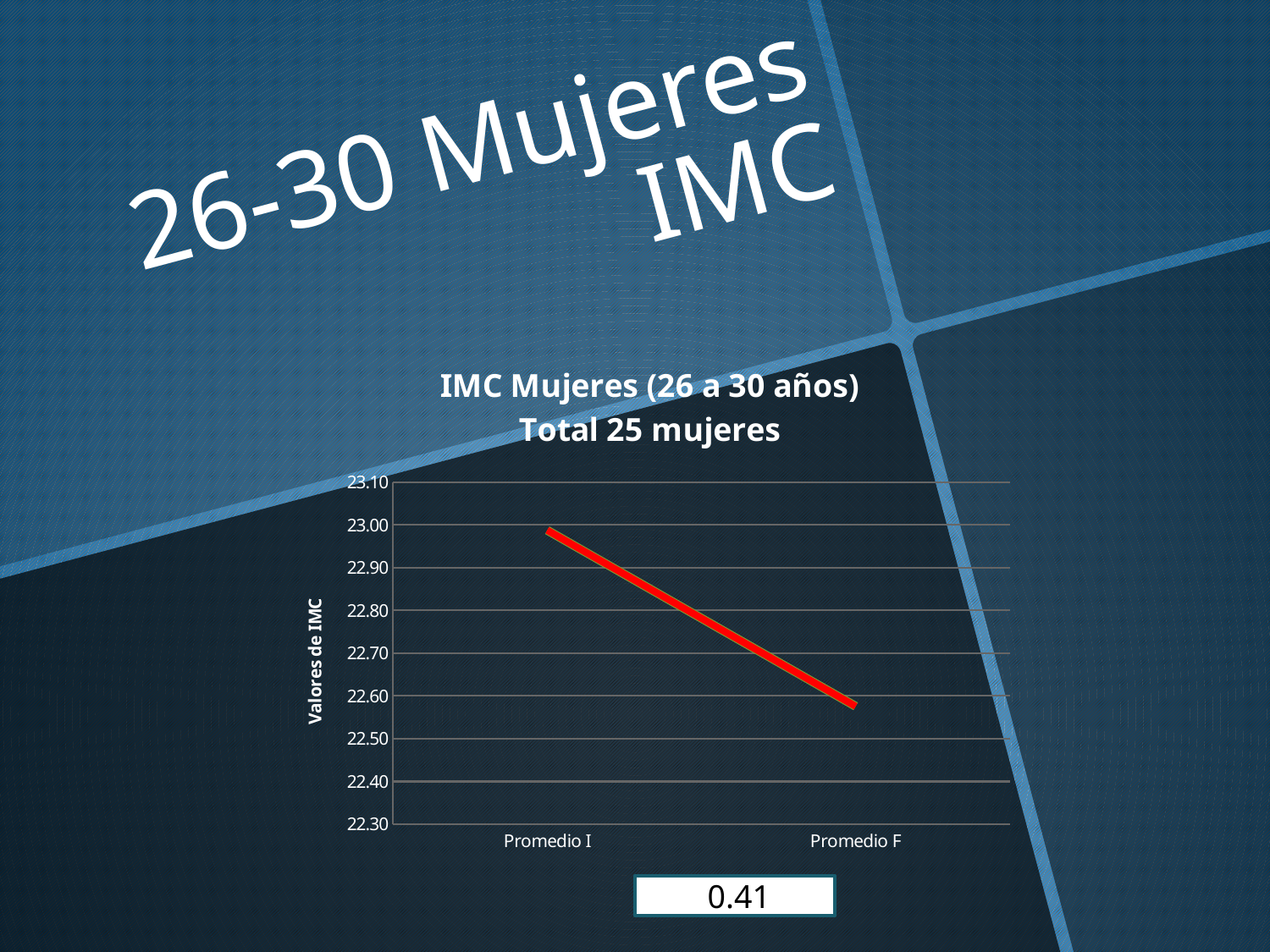
Is the value for Promedio I greater or less than 22.50? greater What is the label of the vertical axis of the chart? Valores de IMC What is the title of the chart? IMC Mujeres (26 a 30 años) Total 25 mujeres Which category has the highest value, Promedio I or Promedio F? Promedio I Which category has the lowest value in the chart? Promedio F Is the value for Promedio I greater or less than 22.90? greater Is the value for Promedio F greater or less than 22.70? less How many categories are plotted on the x axis of the chart? 2 Do the values rise or fall from Promedio I to Promedio F? fall Is the value for Promedio F larger or smaller than the value for Promedio I? smaller What kind of chart is shown on the slide? line chart